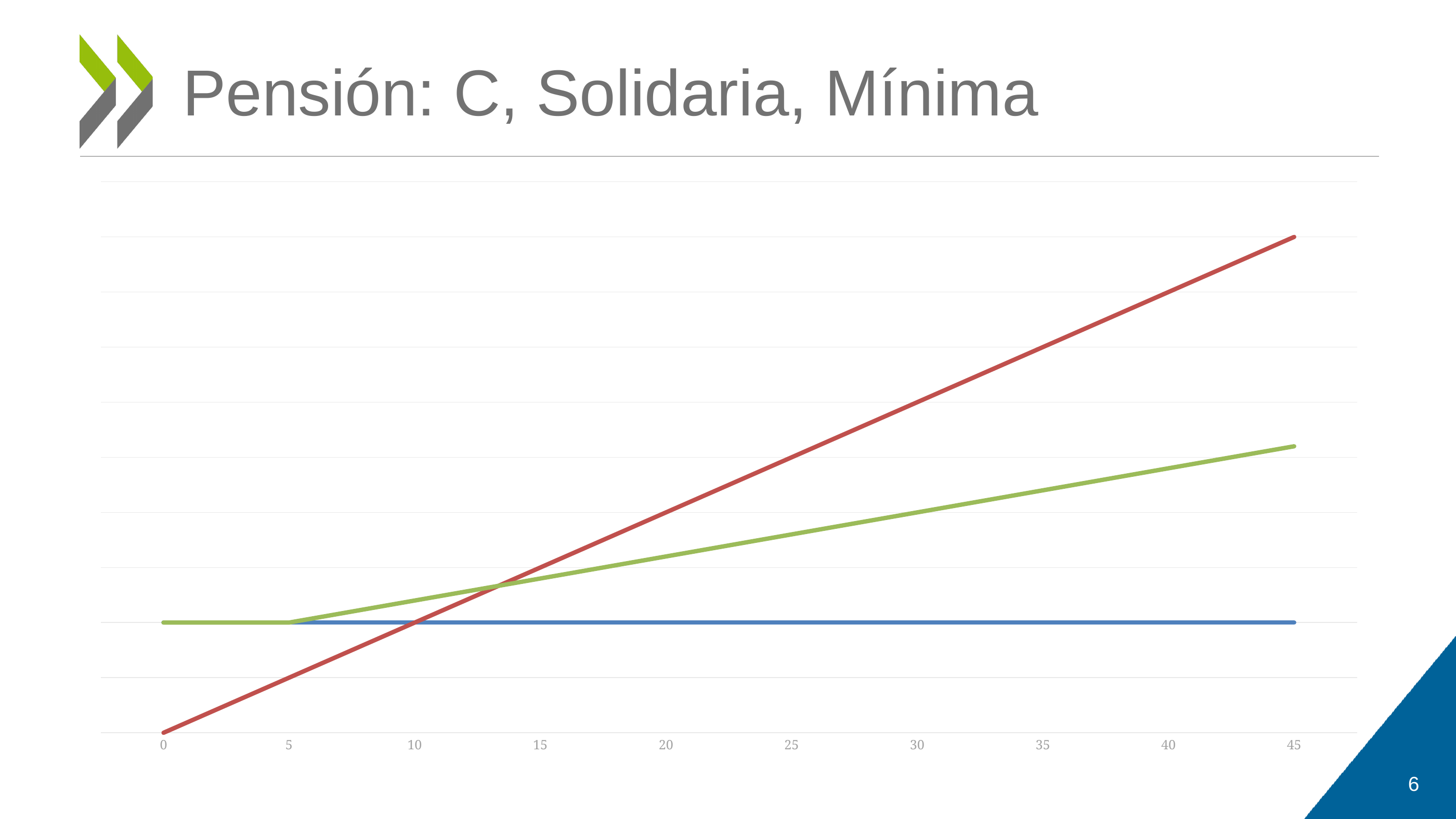
Does the green line rise or fall between x = 5 and x = 45? rise Does the blue line rise, fall or stay flat across the x axis? stay flat At x = 0, which of the three lines is the lowest? red line How many tick labels are shown on the x axis? 10 At x = 0, which line is higher, the red line or the blue line? blue line What is the title of the slide containing the chart? Pensión: C, Solidaria, Mínima What kind of chart is shown on the slide? line chart At x = 45, which of the three lines is the lowest? blue line At x = 45, which line is higher, the red line or the green line? red line Does the red line rise or fall as the x axis goes from 0 to 45? rise What is the highest value labelled on the x axis? 45 How many lines are plotted on the chart? 3